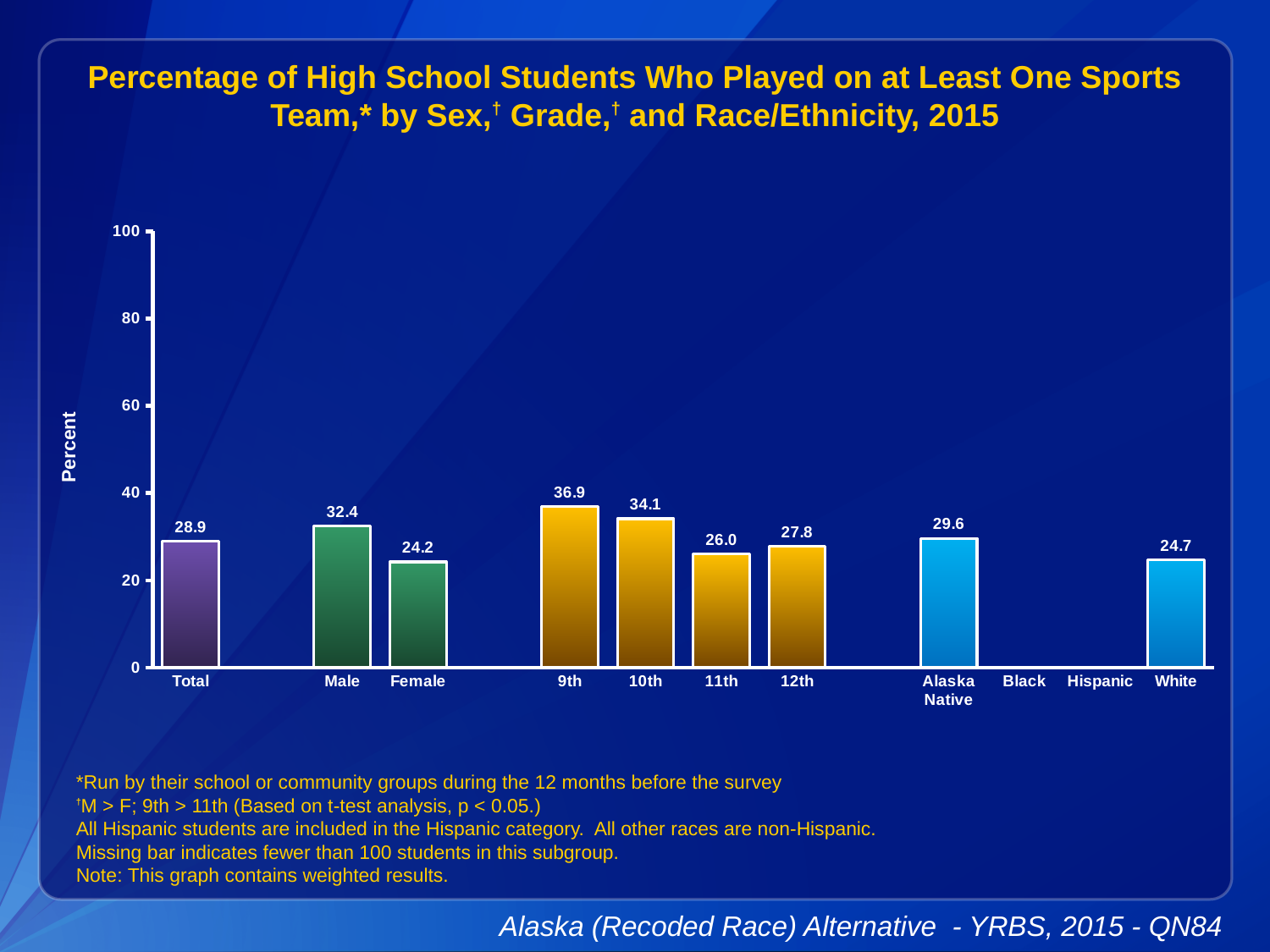
What is the label on the y axis? Percent What is the difference between the Male and Female values? 8.2 Which category has the highest value? 9th What is the value for Female? 24.2 Do the values rise or fall from 9th grade to 11th grade? fall What is the value for Total? 28.9 What kind of chart is shown? bar chart Which is larger, the value for 10th grade or the value for 12th grade? 10th What is the value for 11th grade? 26.0 Which category with a bar has the lowest value? Female Is the value for Alaska Native greater or less than 40? less How many categories have a bar plotted? 9